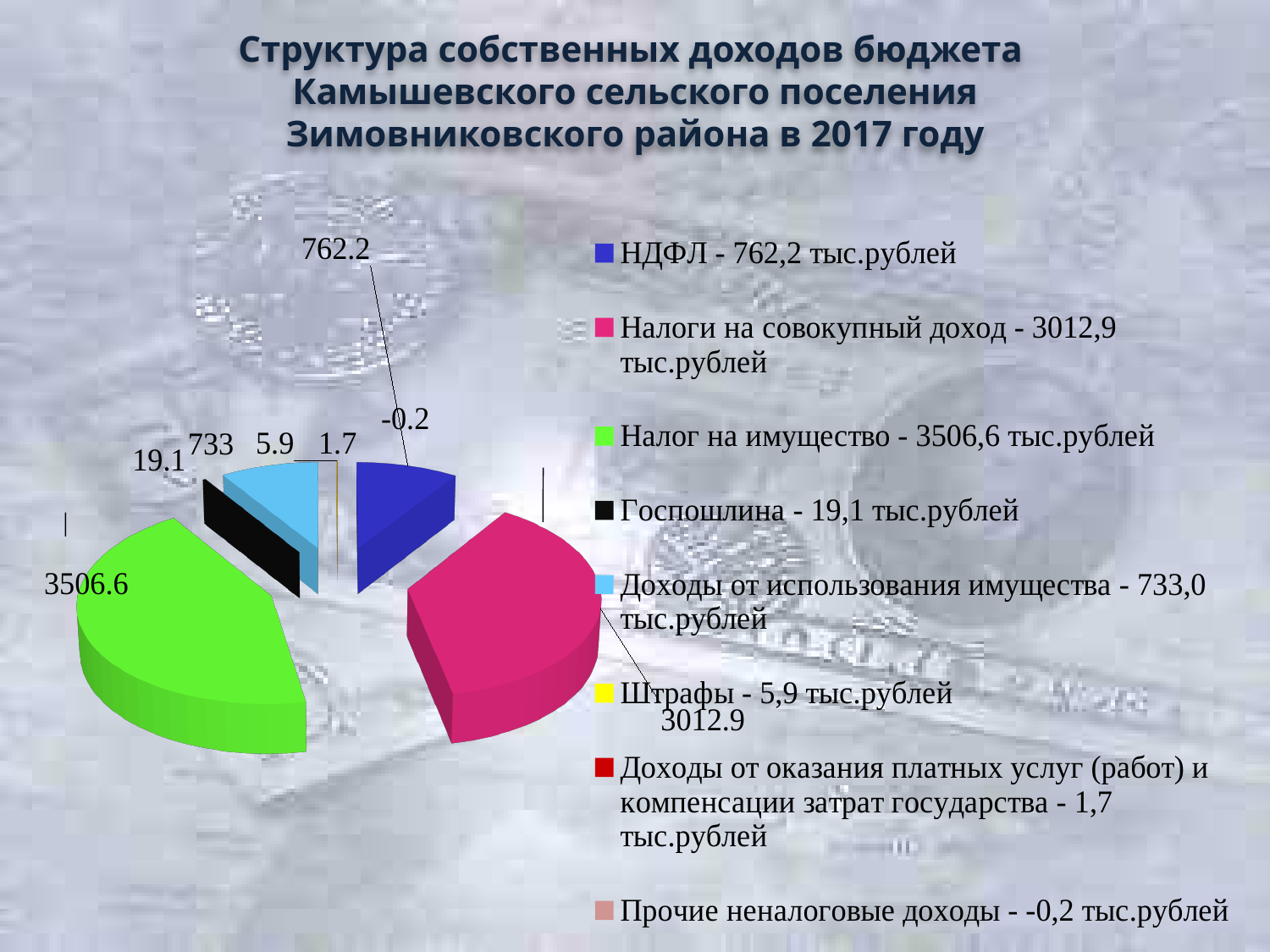
What is the difference between the НДФЛ value and the Доходы от использования имущества value? 29.2 What value is shown for the НДФЛ slice in the pie chart? 762.2 Which category has the largest value in the pie chart? Налог на имущество What value is shown for the Госпошлина slice? 19.1 What kind of chart is shown on the slide? Pie chart How many categories does the legend of the chart list? 8 What value is shown for the Штрафы slice? 5.9 What is the difference between the Налог на имущество value and the Налоги на совокупный доход value? 493.7 What value is shown for the Налог на имущество slice? 3506.6 Which category has the smallest value in the pie chart? Прочие неналоговые доходы Which is larger: НДФЛ or Доходы от использования имущества? НДФЛ What colour is the Налог на имущество slice in the pie chart? Green